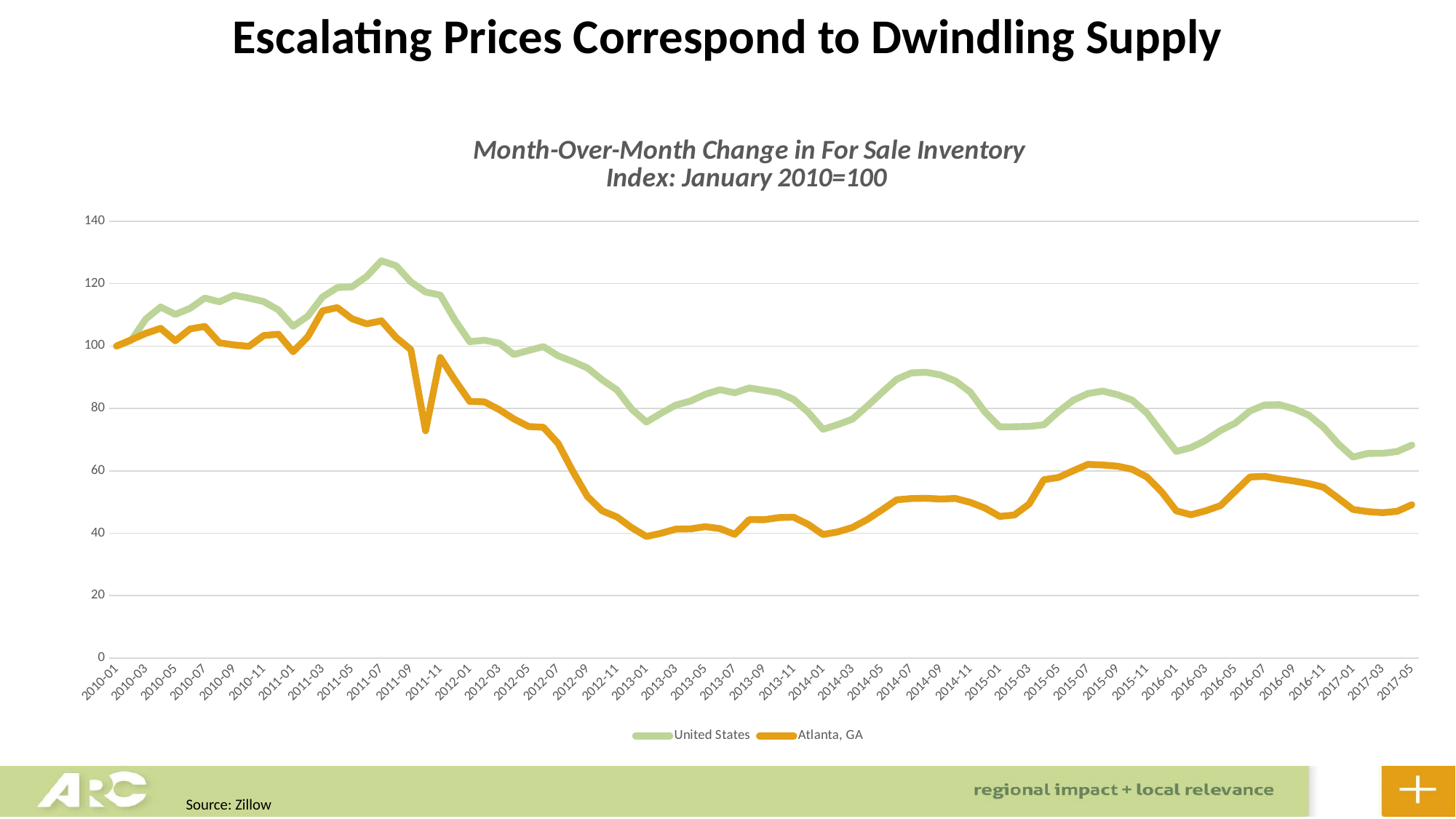
What is the index value for Atlanta, GA at 2010-01? 100 What is the title of the chart? Month-Over-Month Change in For Sale Inventory Index: January 2010=100 What kind of chart is shown on the slide? Line chart Is the value for Atlanta, GA at 2016-01 greater or less than 60? less Overall, do the values for Atlanta, GA rise or fall from 2010-01 to 2017-05? Fall Which series reaches the highest value anywhere on the chart? United States At 2017-05, which series has the higher value, United States or Atlanta, GA? United States Is the value for United States at 2011-07 greater or less than 120? greater Is the value for Atlanta, GA at 2011-11 greater or less than 80? greater What are the two series shown in the legend? United States and Atlanta, GA How many series does the legend list? 2